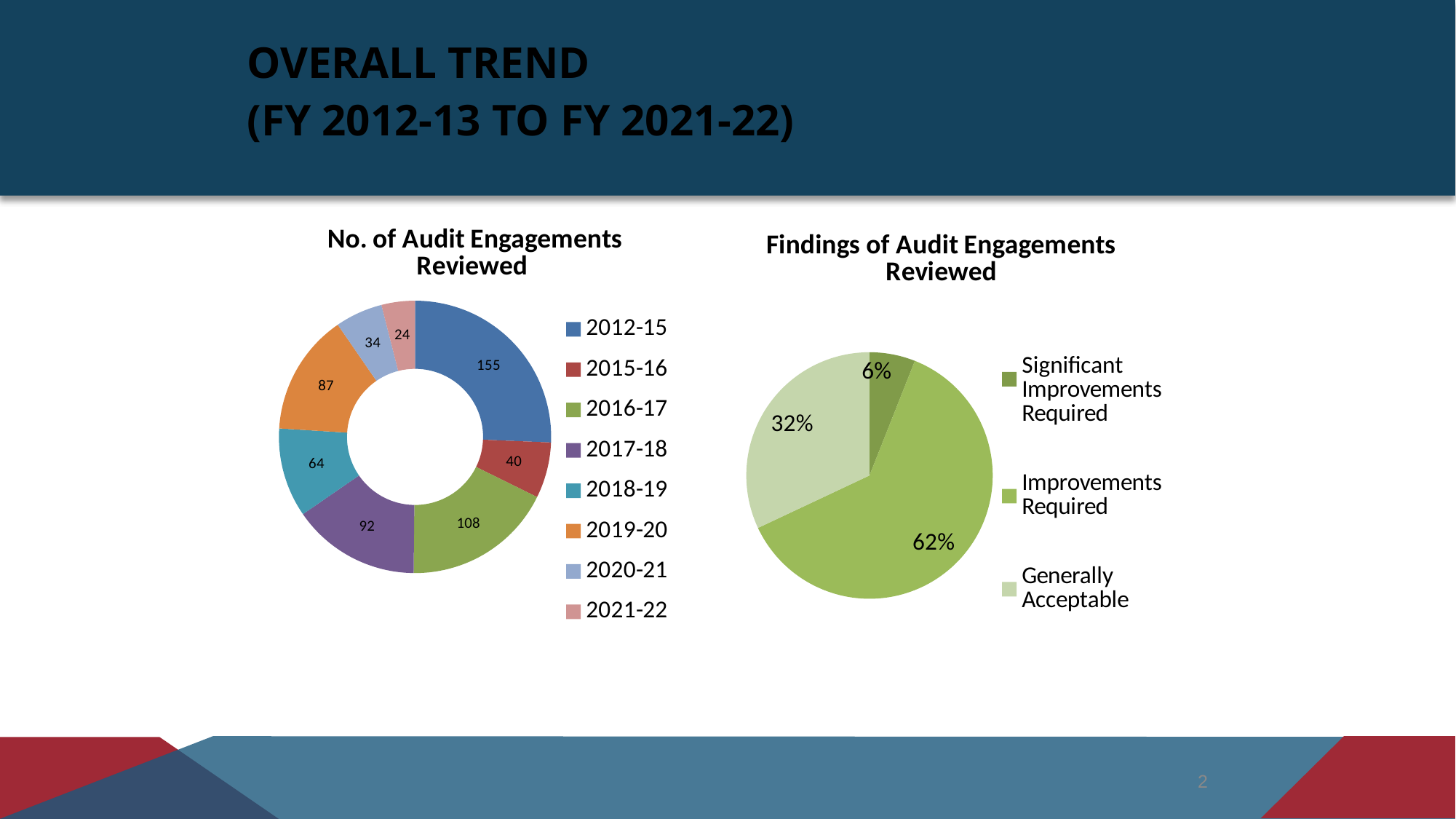
What kind of chart is the 'No. of Audit Engagements Reviewed' chart? Doughnut chart In the 'Findings of Audit Engagements Reviewed' chart, what share of findings is 'Generally Acceptable'? 32% In the 'Findings of Audit Engagements Reviewed' chart, what share of findings is 'Significant Improvements Required'? 6% In the 'No. of Audit Engagements Reviewed' chart, which period has the highest number of audit engagements reviewed? 2012-15 How many categories does the legend of the 'Findings of Audit Engagements Reviewed' chart list? 3 In the 'No. of Audit Engagements Reviewed' chart, which is larger: the value for 2019-20 or the value for 2018-19? 2019-20 In the 'Findings of Audit Engagements Reviewed' chart, which category has the largest share? Improvements Required How many periods are shown in the 'No. of Audit Engagements Reviewed' chart? 8 In the 'No. of Audit Engagements Reviewed' chart, what is the difference between the values for 2016-17 and 2015-16? 68 In the 'No. of Audit Engagements Reviewed' chart, what is the value for 2012-15? 155 In the 'No. of Audit Engagements Reviewed' chart, what is the value for 2017-18? 92 In the 'No. of Audit Engagements Reviewed' chart, which period has the lowest number of audit engagements reviewed? 2021-22